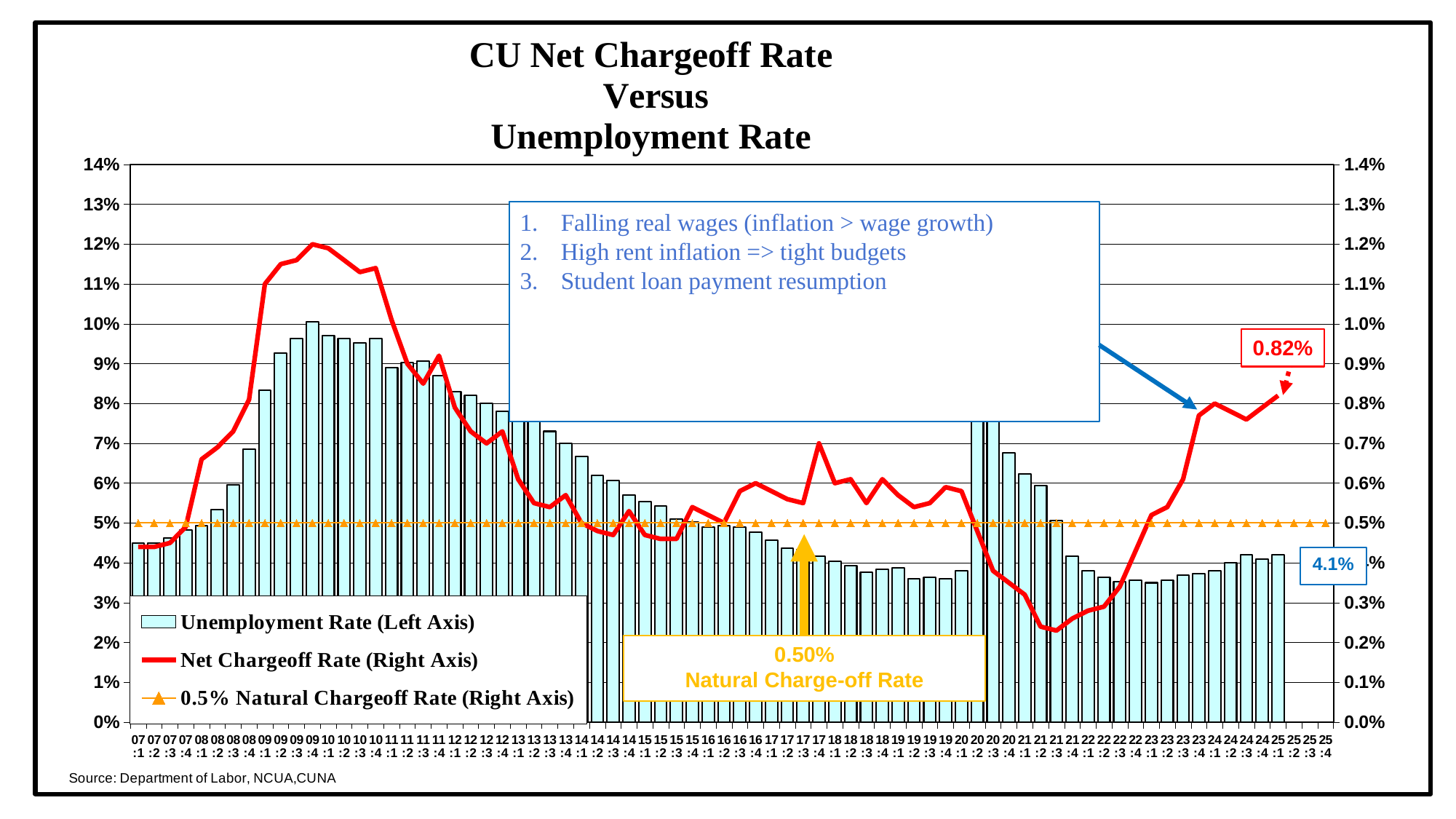
What is the latest Net Chargeoff Rate value labeled on the chart? 0.82% Does the Net Chargeoff Rate rise or fall from 21:2 to 25:1? rise What is the Natural Charge-off Rate shown on the chart? 0.50% How many series does the legend list? 3 Which is larger at the end of the chart: the Net Chargeoff Rate or the 0.5% Natural Chargeoff Rate? Net Chargeoff Rate Is the Net Chargeoff Rate at 09:4 greater or less than 1.1%? greater Is the Net Chargeoff Rate at 21:2 greater or less than 0.3%? less Is the Unemployment Rate at 10:1 greater or less than 10%? less On which axis is the Unemployment Rate plotted? Left axis By how much does the latest Net Chargeoff Rate (0.82%) exceed the 0.50% Natural Charge-off Rate? 0.32 percentage points What is the latest Unemployment Rate value labeled on the chart? 4.1% What kind of chart is shown on the slide? A combined bar and line chart